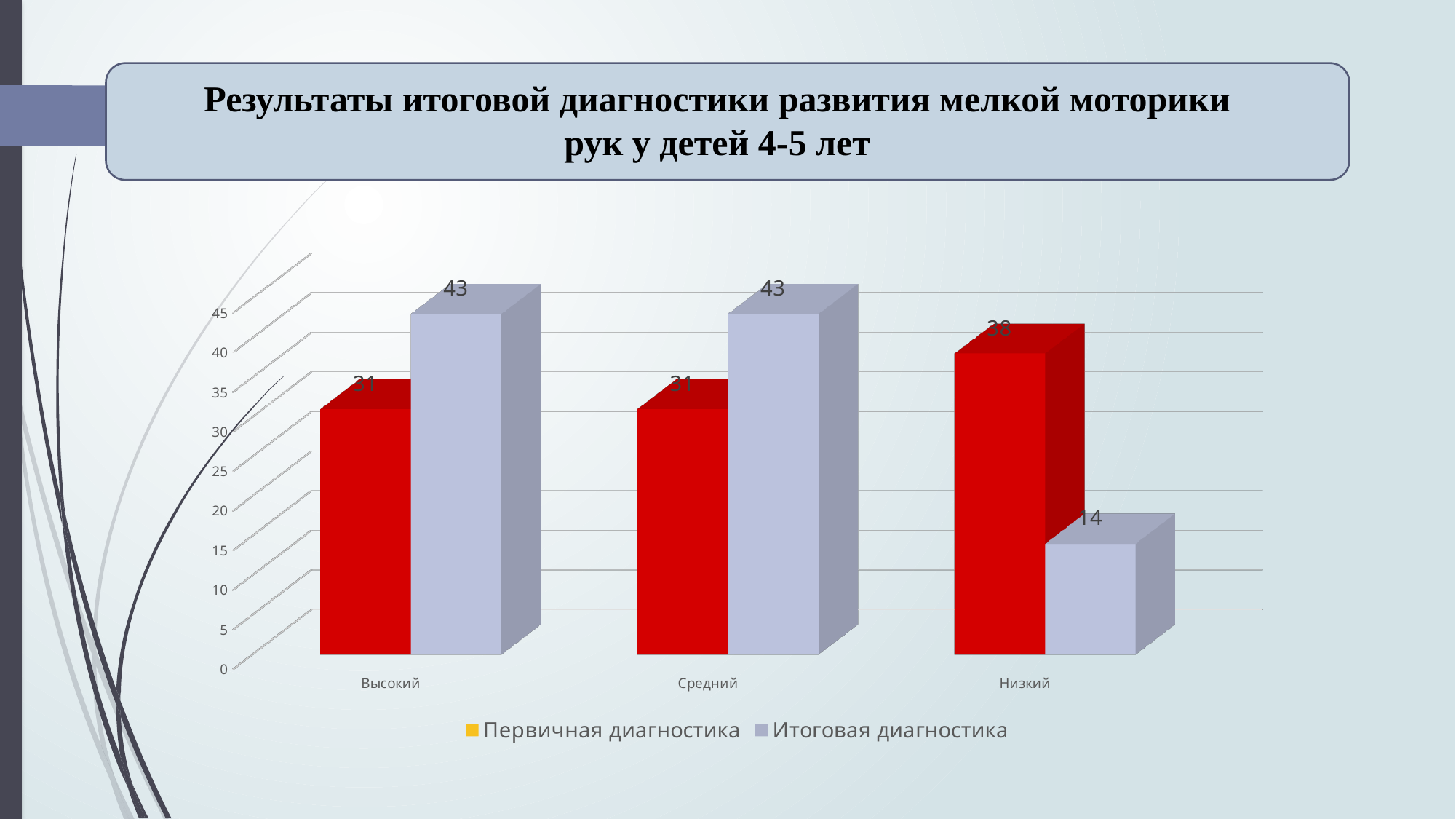
How many series does the legend list? 2 Which category has the highest value for Первичная диагностика? Низкий What is the value of Первичная диагностика for Низкий? 38 What is the value of Итоговая диагностика for Высокий? 43 How many categories are shown on the x axis? 3 What is the difference between Первичная диагностика and Итоговая диагностика for Низкий? 24 For Средний, which is larger: Первичная диагностика or Итоговая диагностика? Итоговая диагностика Which category has the lowest value for Итоговая диагностика? Низкий What kind of chart is shown on the slide? Bar chart What is the value of Итоговая диагностика for Низкий? 14 What is the value of Первичная диагностика for Средний? 31 What is the difference between Итоговая диагностика and Первичная диагностика for Высокий? 12